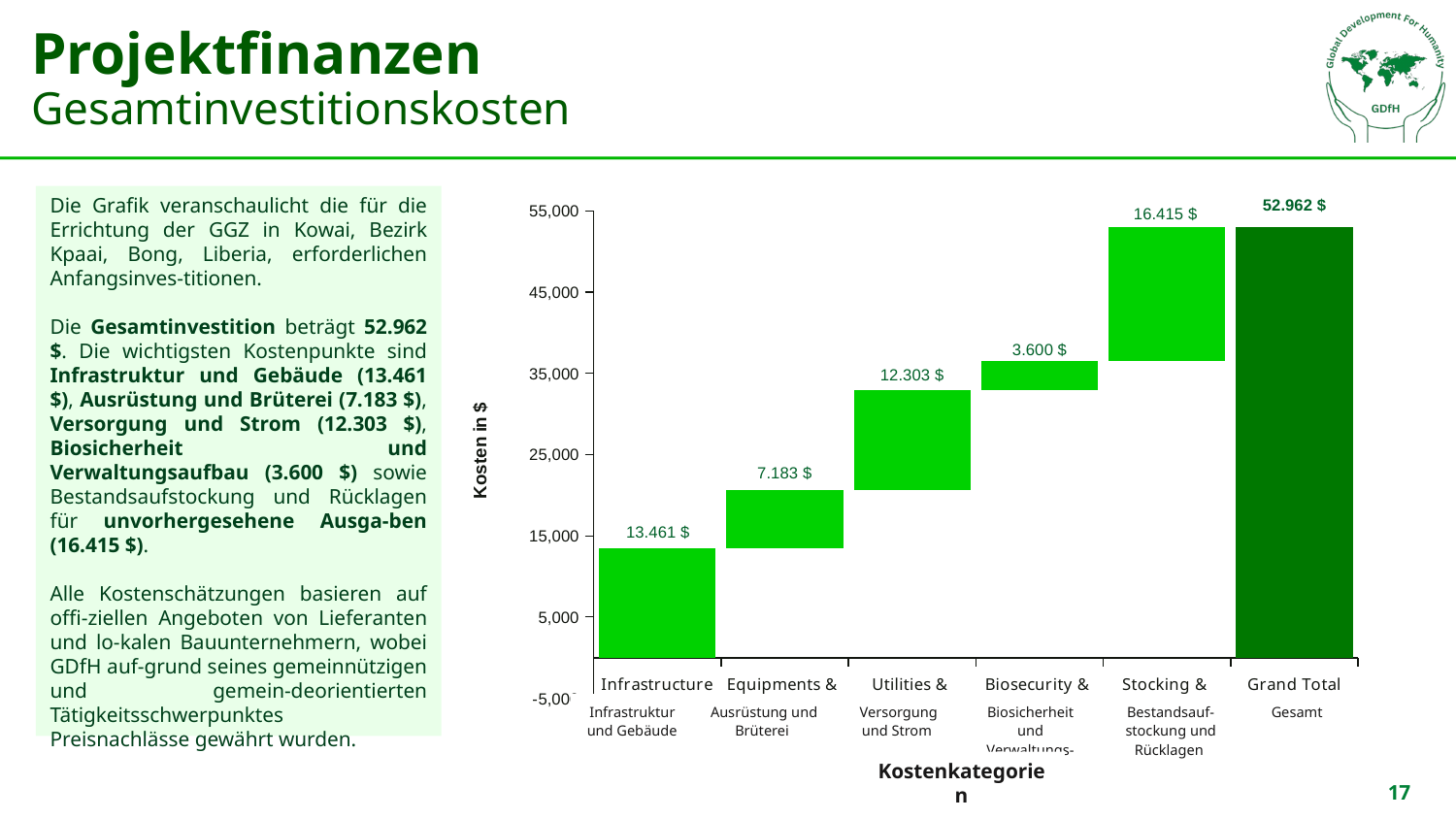
What is the label of the vertical axis? Kosten in $ What kind of chart is shown on the slide? waterfall bar chart What is the Grand Total value shown in the chart? 52.962 $ Which cost category has the lowest value? Biosecurity & What is the value shown for Stocking & (Bestandsaufstockung und Rücklagen)? 16.415 $ What is the value shown for Infrastructure? 13.461 $ What is the difference between the Stocking & value and the Infrastructure value? 2.954 $ What is the value shown for Biosecurity &? 3.600 $ How many categories are shown on the x axis, including Grand Total? 6 Which is larger, the value for Utilities & or the value for Equipments &? Utilities & Excluding the Grand Total, which cost category has the highest value? Stocking & What is the difference between the Utilities & value and the Equipments & value? 5.120 $